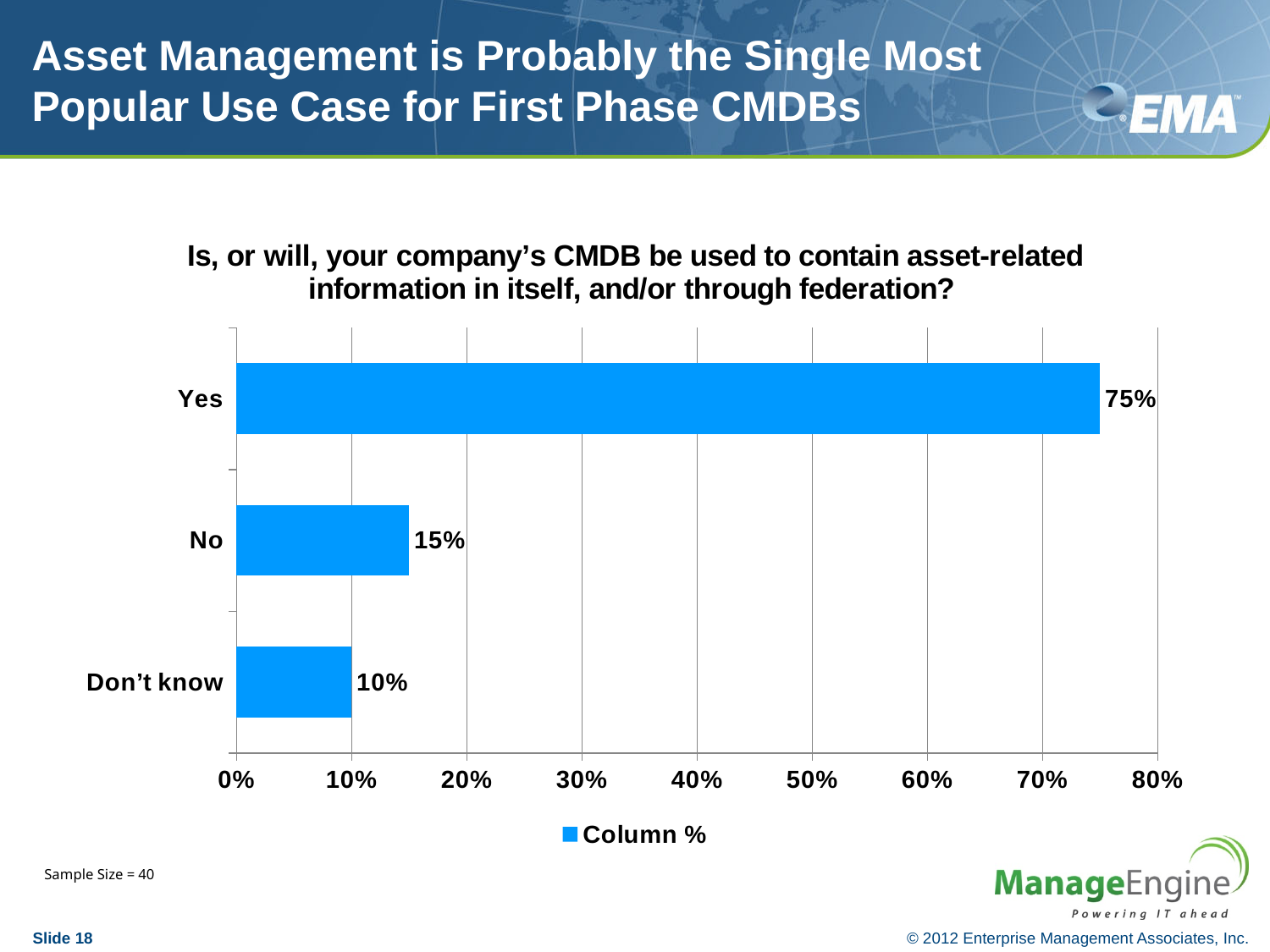
Is the value for "Yes" greater or less than 70%? greater What is the value for "Yes"? 75% Which category has the lowest value? Don't know How many categories are shown in the chart? 3 Which is larger, the value for "No" or the value for "Don't know"? No What is the value for "No"? 15% Which category has the highest value? Yes What is the difference between the values for "Yes" and "No"? 60% What is the value for "Don't know"? 10% What kind of chart is shown on the slide? bar chart What is the difference between the values for "No" and "Don't know"? 5% What series name does the legend show? Column %